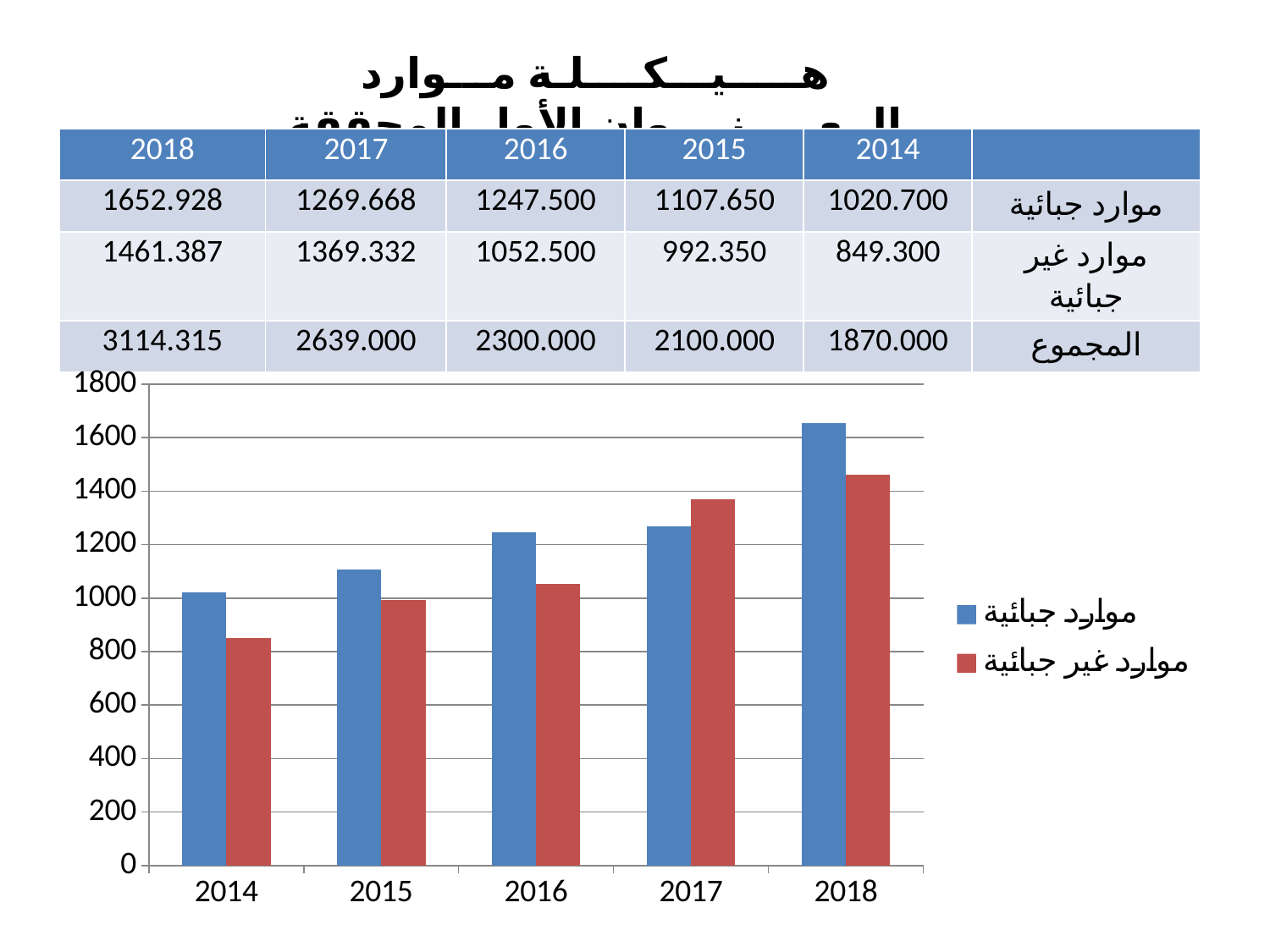
According to the table on the slide, what is the value of موارد جبائية in 2018? 1652.928 In 2016, which is larger: موارد جبائية or موارد غير جبائية? موارد جبائية Do the values for موارد جبائية rise or fall from 2014 to 2018? rise How many series does the chart legend list? 2 Which colour represents موارد غير جبائية in the chart? red Which year has the lowest value for موارد غير جبائية? 2014 Is the value for موارد جبائية in 2018 greater or less than 1600? greater What kind of chart is shown on the slide? bar chart Which year has the highest value for موارد جبائية? 2018 How many years are shown on the x axis of the chart? 5 In 2017, which is larger: موارد جبائية or موارد غير جبائية? موارد غير جبائية Is the value for موارد غير جبائية in 2014 greater or less than 1000? less